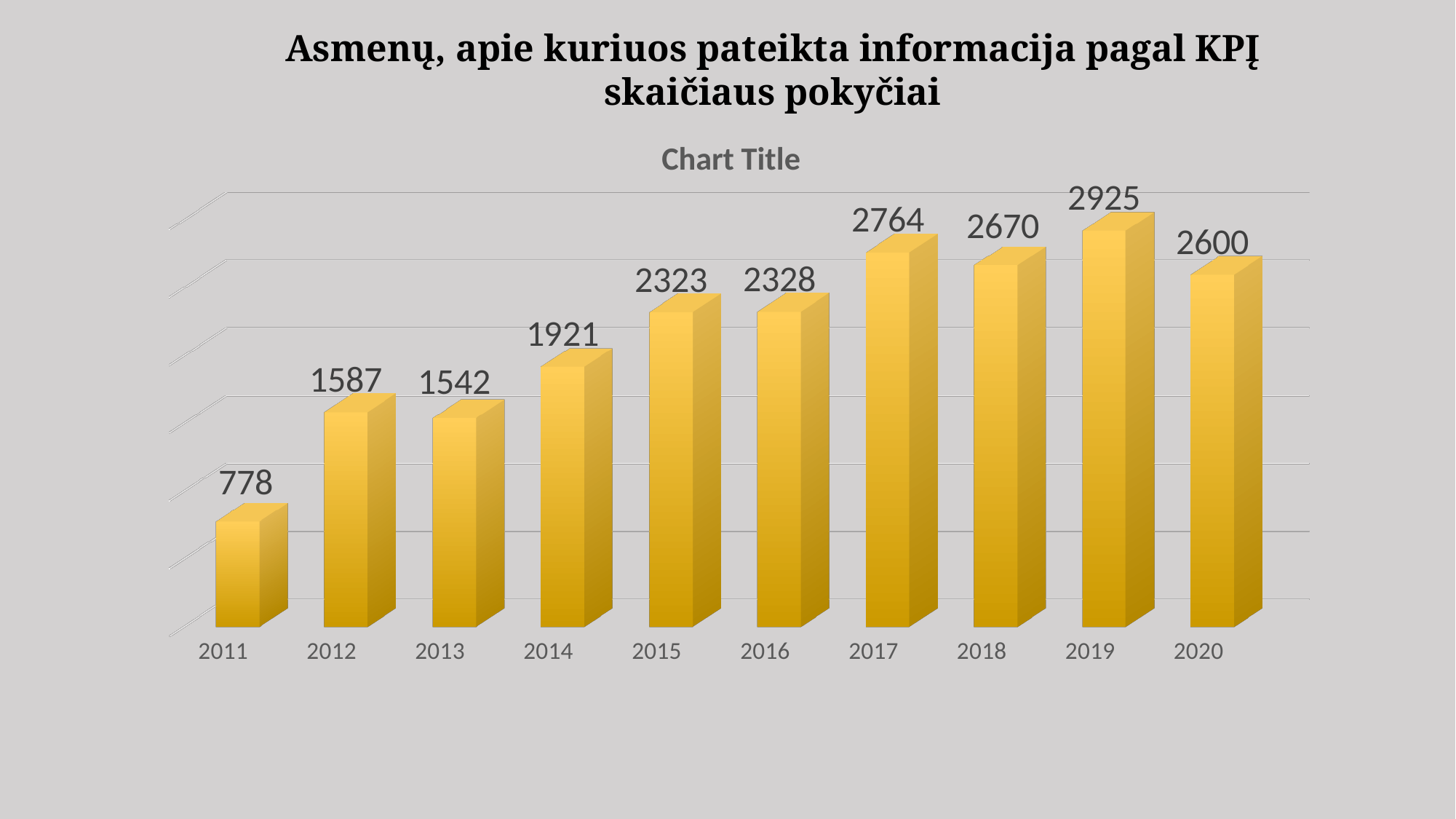
Which year has the lowest value? 2011 What kind of chart is shown on the slide? bar chart Which year has the highest value? 2019 What is the difference between the values for 2019 and 2020? 325 What is the value for 2017? 2764 What is the value for 2011? 778 What is the value for 2020? 2600 Do the values generally rise or fall from 2011 to 2019? rise Which is larger, the value for 2017 or the value for 2018? 2017 Which is larger, the value for 2014 or the value for 2013? 2014 What is the difference between the values for 2012 and 2011? 809 How many years are shown on the x axis? 10